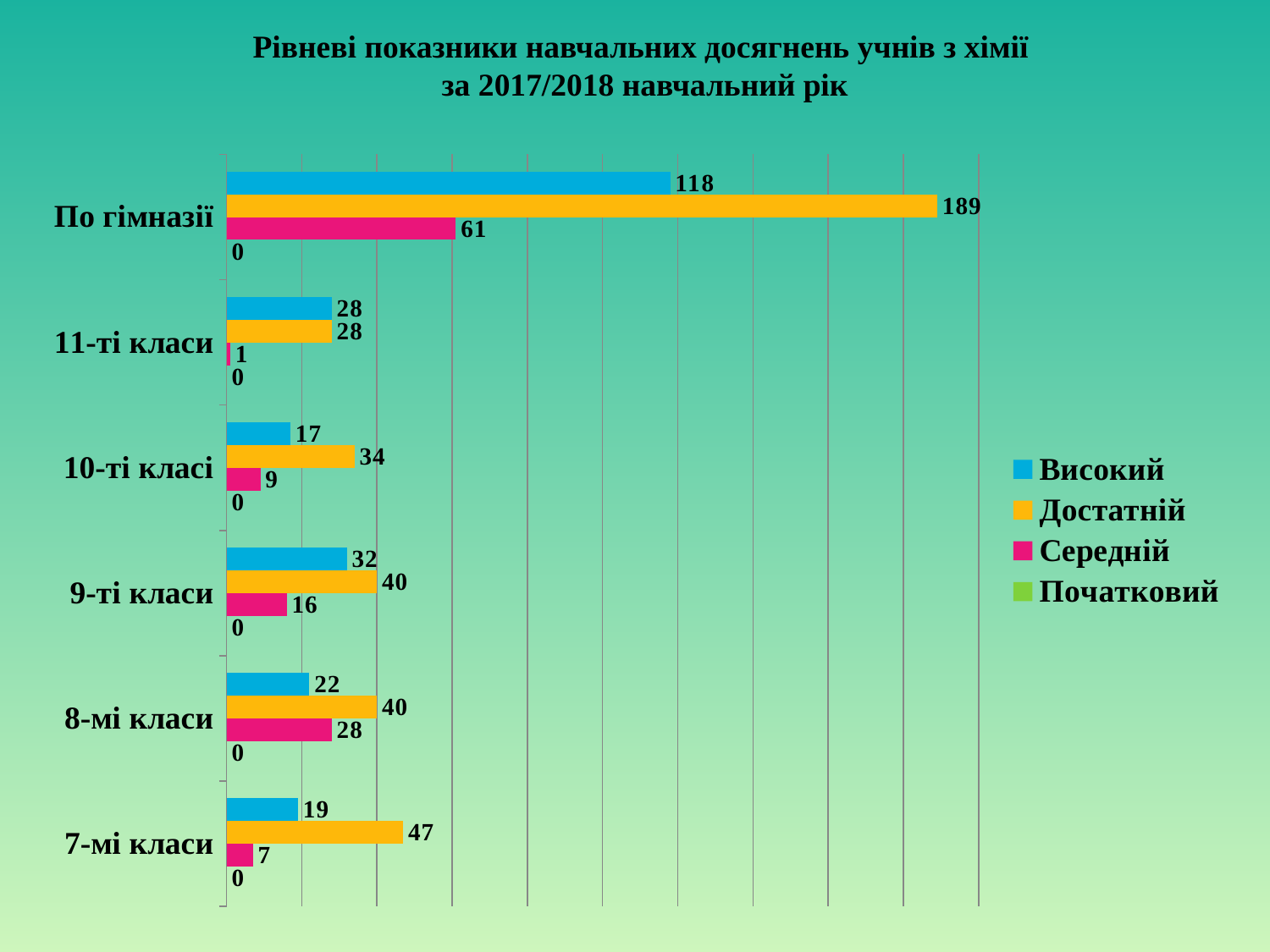
What is the value for Середній for 11-ті класи? 1 What is the value for Достатній for По гімназії? 189 How many categories are shown on the y axis? 6 What is the difference between the Достатній and Високий values for По гімназії? 71 What is the value for Початковий for 10-ті класі? 0 Which class category has the lowest value for Середній? 11-ті класи Which is larger for 8-мі класи: Високий or Середній? Середній How many series does the legend list? 4 What kind of chart is shown on the slide? bar chart What is the value for Середній for 7-мі класи? 7 Which class category has the highest value for Достатній (excluding По гімназії)? 7-мі класи What is the value for Високий for 9-ті класи? 32